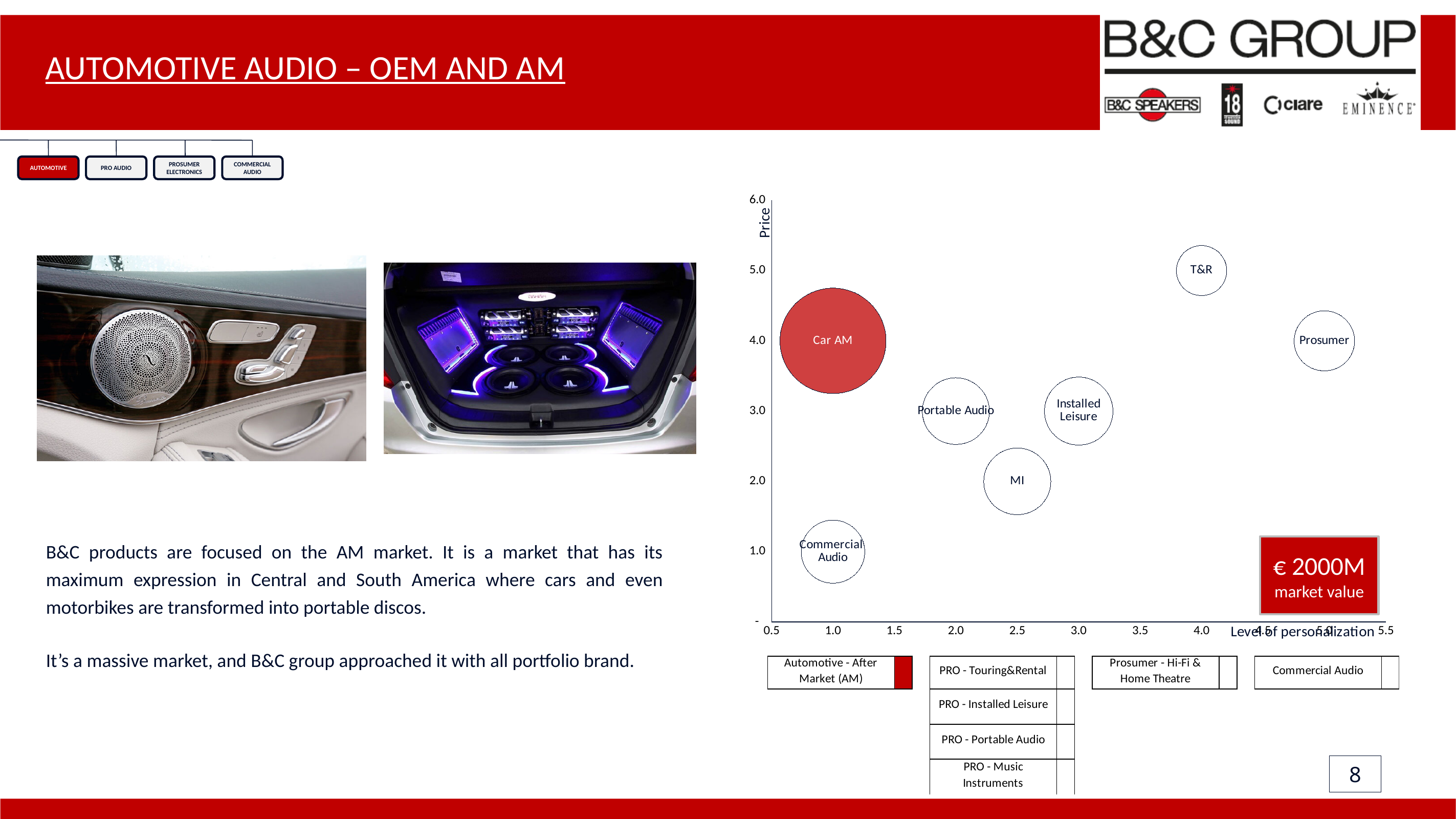
Which bubble has the lowest Price value on the chart? Commercial Audio How many bubbles are plotted on the chart? 7 Which bubble has the highest Price value on the chart? T&R Is the Price value for Car AM greater or less than 3.0? greater Which bubble is drawn largest and filled in red on the chart? Car AM Is the Level of personalization for Installed Leisure greater or less than 2.0? greater Which bubble has a higher Price, Portable Audio or MI? Portable Audio What is the Price value for the T&R bubble? 5.0 What is the Price value for the Commercial Audio bubble? 1.0 Which bubble has the highest Level of personalization on the chart? Prosumer What kind of chart is shown on the right side of the slide? bubble chart What is the Price value for the MI bubble? 2.0